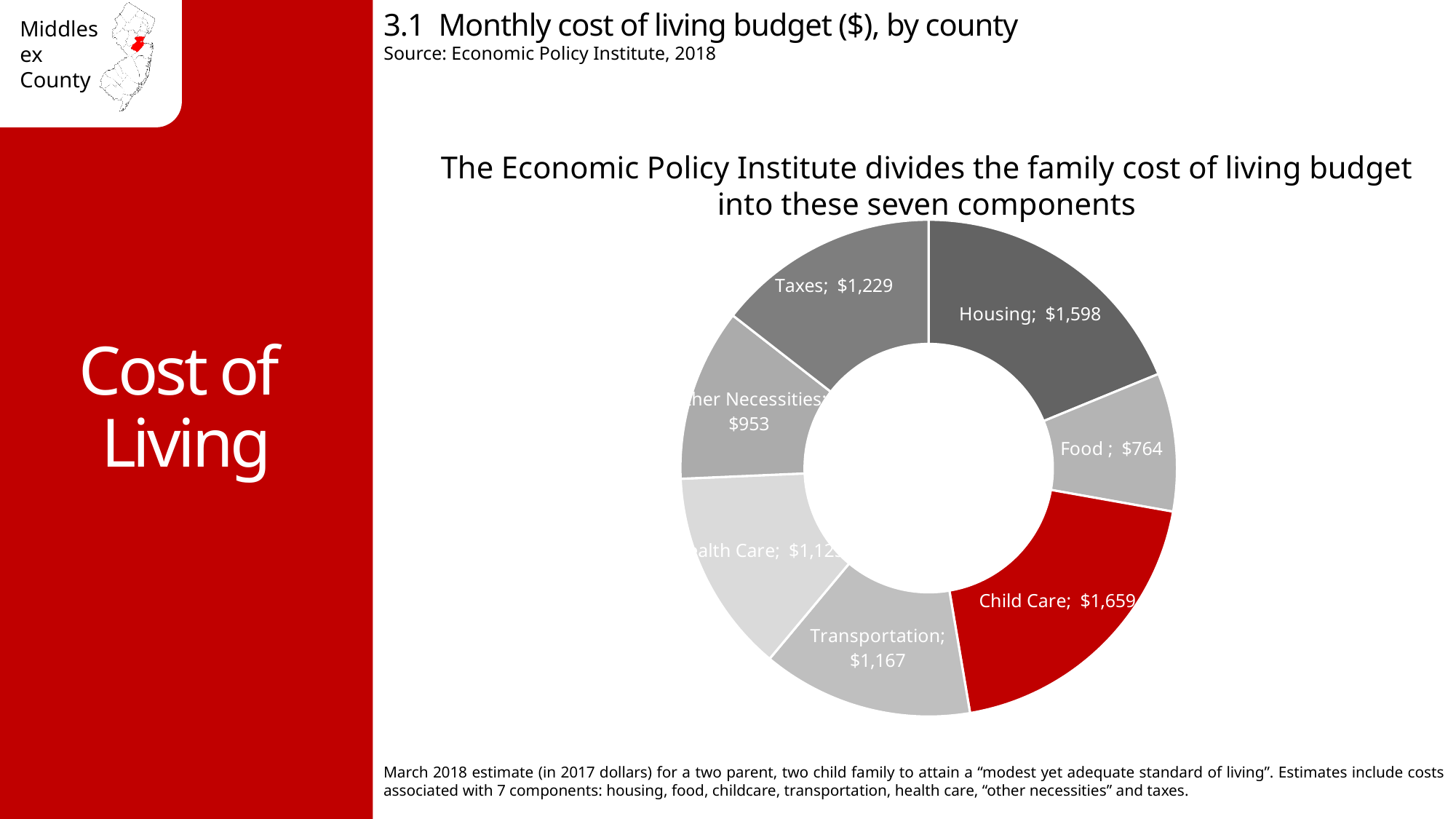
Which component has the smallest monthly cost? Food Which is larger, the cost for Taxes or the cost for Transportation? Taxes What kind of chart is used on this slide? Doughnut chart What is the monthly cost for Child Care shown on the chart? $1,659 What is the monthly cost for Transportation shown on the chart? $1,167 What is the monthly cost for Other Necessities shown on the chart? $953 What is the monthly cost for Taxes shown on the chart? $1,229 What is the difference between the Housing cost and the Food cost? $834 Which component has the largest monthly cost? Child Care What is the monthly cost for Housing shown on the chart? $1,598 What is the monthly cost for Food shown on the chart? $764 How many components are shown in the chart? 7